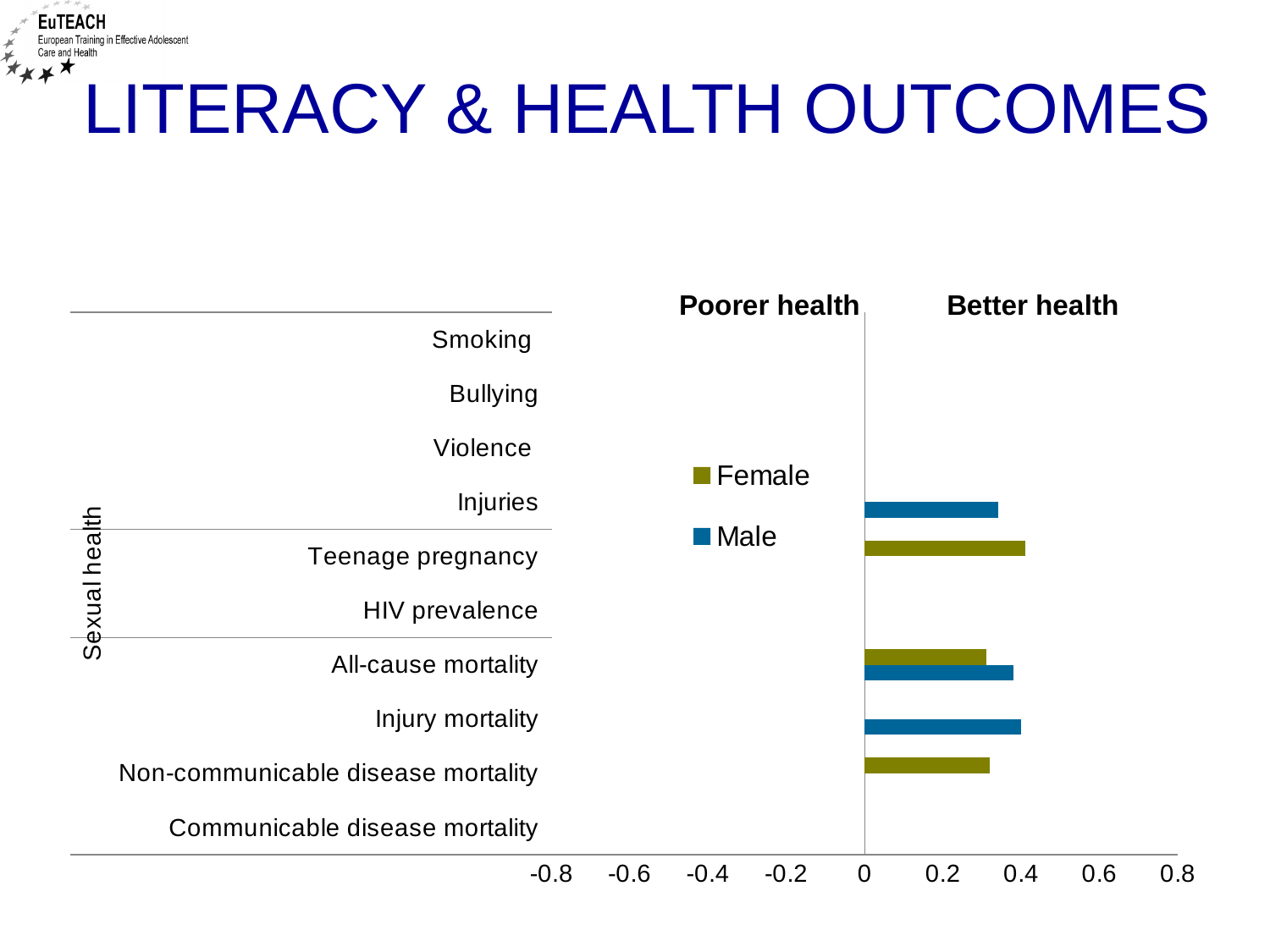
What is the lowest value shown on the horizontal axis? -0.8 Is the Male value for Injury mortality greater or less than 0.2? greater For All-cause mortality, which series has the larger value, Female or Male? Male Is the Male value for Injuries greater or less than 0.4? less Which side of the zero line is labelled 'Better health'? The right side Is the Female value for Teenage pregnancy greater or less than 0.2? greater Which two series are listed in the legend? Female and Male What kind of chart is shown on the slide? Bar chart How many health outcome categories are listed on the vertical axis? 10 How many series does the legend list? 2